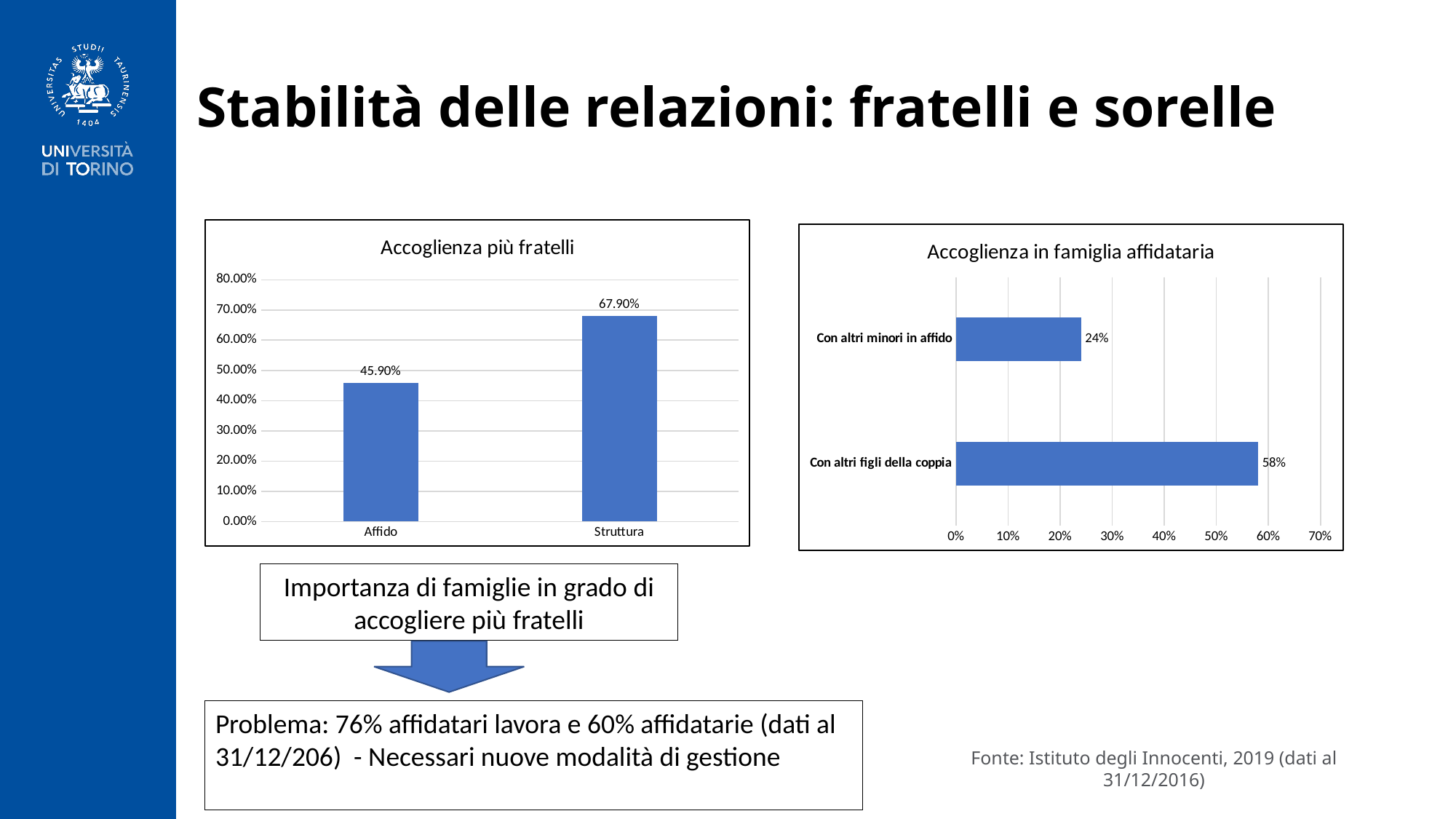
In the 'Accoglienza in famiglia affidataria' chart, what is the value for 'Con altri minori in affido'? 24% In the 'Accoglienza più fratelli' chart, what is the difference between Struttura and Affido? 22.00% In the 'Accoglienza più fratelli' chart, how many categories are shown? 2 In the 'Accoglienza in famiglia affidataria' chart, what is the value for 'Con altri figli della coppia'? 58% In the 'Accoglienza più fratelli' chart, what is the value for Affido? 45.90% In the 'Accoglienza in famiglia affidataria' chart, which category has the lowest value? Con altri minori in affido What kind of chart is 'Accoglienza più fratelli'? Bar chart In the 'Accoglienza più fratelli' chart, what is the value for Struttura? 67.90% In the 'Accoglienza in famiglia affidataria' chart, what is the difference between 'Con altri figli della coppia' and 'Con altri minori in affido'? 34% What is the title of the chart on the right side of the slide? Accoglienza in famiglia affidataria In the 'Accoglienza in famiglia affidataria' chart, is the value for 'Con altri figli della coppia' greater or less than 50%? greater In the 'Accoglienza più fratelli' chart, which category has the highest value? Struttura